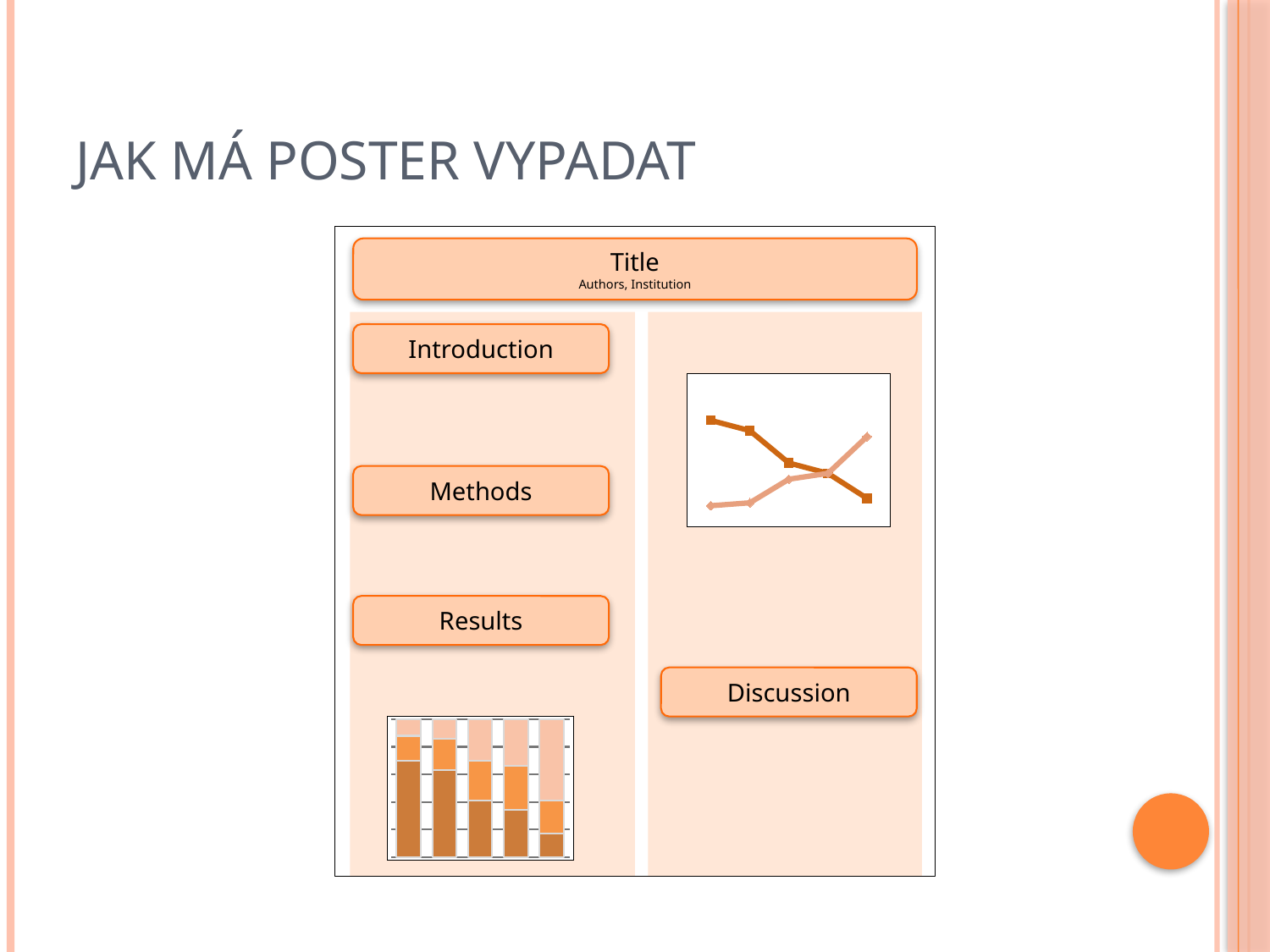
In the bar chart at the bottom left of the poster, which bar has the tallest light pink top segment? the rightmost bar In the bar chart at the bottom left of the poster, is the dark brown bottom segment larger in the leftmost bar or the rightmost bar? leftmost bar In the line chart in the right-hand column, how many lines are plotted? 2 In the line chart in the right-hand column, do the two lines cross each other? yes In the bar chart at the bottom left of the poster, how many stacked segments does each bar have? 3 In the line chart in the right-hand column, how many points does the dark orange line have? 5 In the line chart in the right-hand column, does the light pink line rise or fall from left to right? rise In the bar chart at the bottom left of the poster, how many bars are there? 5 What kind of chart is shown at the bottom of the left-hand column of the poster? bar chart In the bar chart at the bottom left of the poster, does the dark brown bottom segment get taller or shorter from left to right? shorter What kind of chart is shown in the right-hand column of the poster? line chart In the line chart in the right-hand column, does the dark orange line rise or fall from left to right? fall